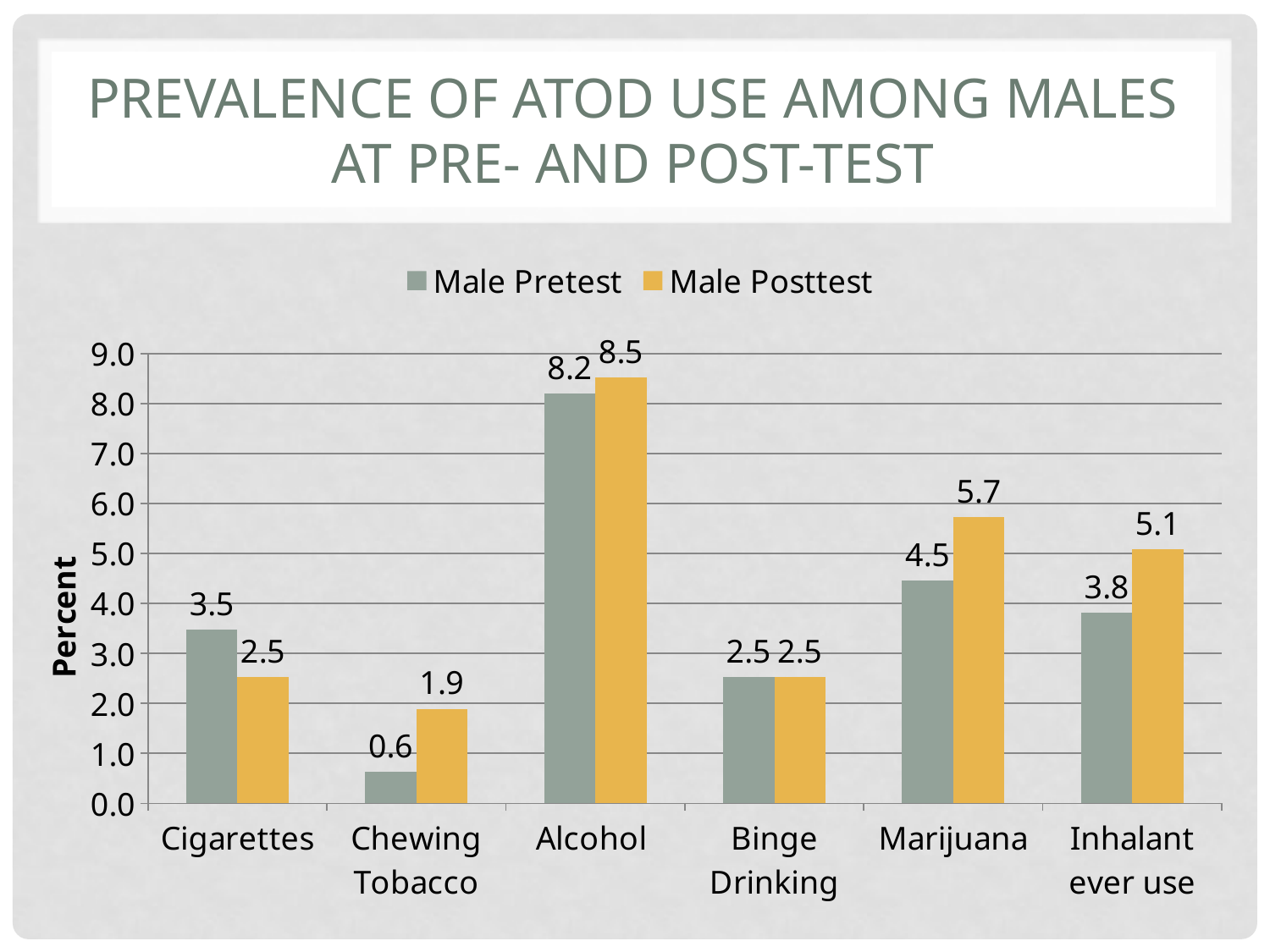
What is the label of the y axis? Percent What is the Male Posttest value for Chewing Tobacco? 1.9 Which is larger for Inhalant ever use, the Male Pretest value or the Male Posttest value? Male Posttest Which category has the highest Male Posttest value? Alcohol What is the Male Posttest value for Inhalant ever use? 5.1 What is the difference between the Male Pretest and Male Posttest values for Cigarettes? 1.0 What is the Male Pretest value for Cigarettes? 3.5 Which category has the lowest Male Pretest value? Chewing Tobacco What kind of chart is shown on the slide? Bar chart How many series does the legend list? 2 How many categories are shown on the x axis? 6 What is the difference between the Male Posttest and Male Pretest values for Marijuana? 1.2